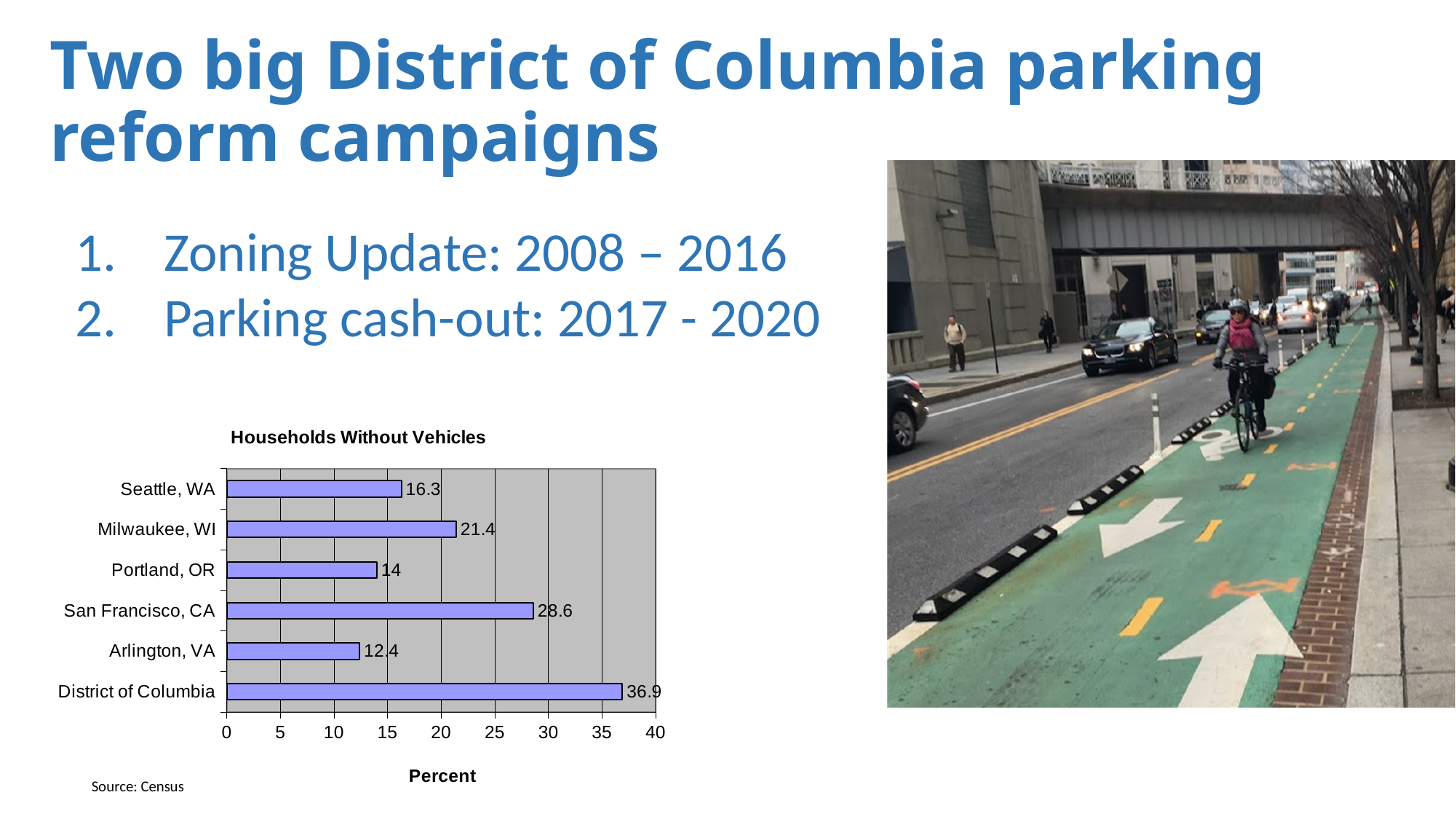
How many categories are shown in the Households Without Vehicles chart? 6 What is the difference between the values for District of Columbia and Arlington, VA in the Households Without Vehicles chart? 24.5 What is the value for District of Columbia in the Households Without Vehicles chart? 36.9 What is the value for Portland, OR in the Households Without Vehicles chart? 14 What is the value for San Francisco, CA in the Households Without Vehicles chart? 28.6 What kind of chart is the Households Without Vehicles chart? Bar chart Is the value for San Francisco, CA in the Households Without Vehicles chart greater or less than 25? greater What is the difference between the values for Milwaukee, WI and Seattle, WA in the Households Without Vehicles chart? 5.1 Which is larger in the Households Without Vehicles chart, the value for Seattle, WA or Milwaukee, WI? Milwaukee, WI What is the x-axis label of the Households Without Vehicles chart? Percent Which category has the lowest value in the Households Without Vehicles chart? Arlington, VA Which category has the highest value in the Households Without Vehicles chart? District of Columbia